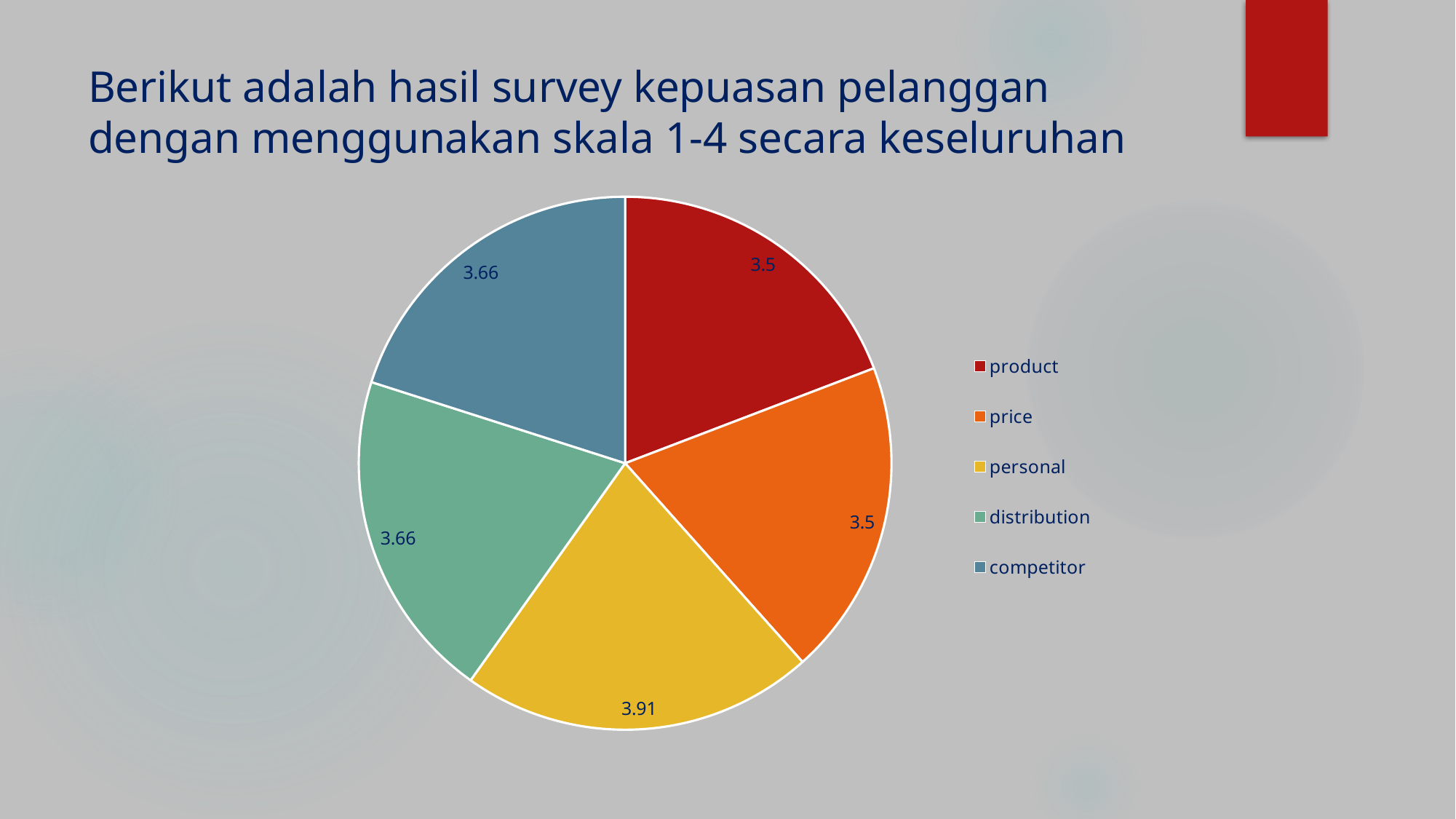
What is the difference between the distribution value and the product value? 0.16 What colour is the personal slice in the pie chart? yellow How many entries does the legend list? 5 What is the value shown for the product slice? 3.5 What is the value shown for the competitor slice? 3.66 How many slices does the pie chart have? 5 What is the difference between the personal value and the price value? 0.41 What is the value shown for the personal slice? 3.91 Which category has the highest value in the pie chart? personal Which is larger, the value for personal or the value for competitor? personal What kind of chart is shown on the slide? pie chart What is the value shown for the distribution slice? 3.66